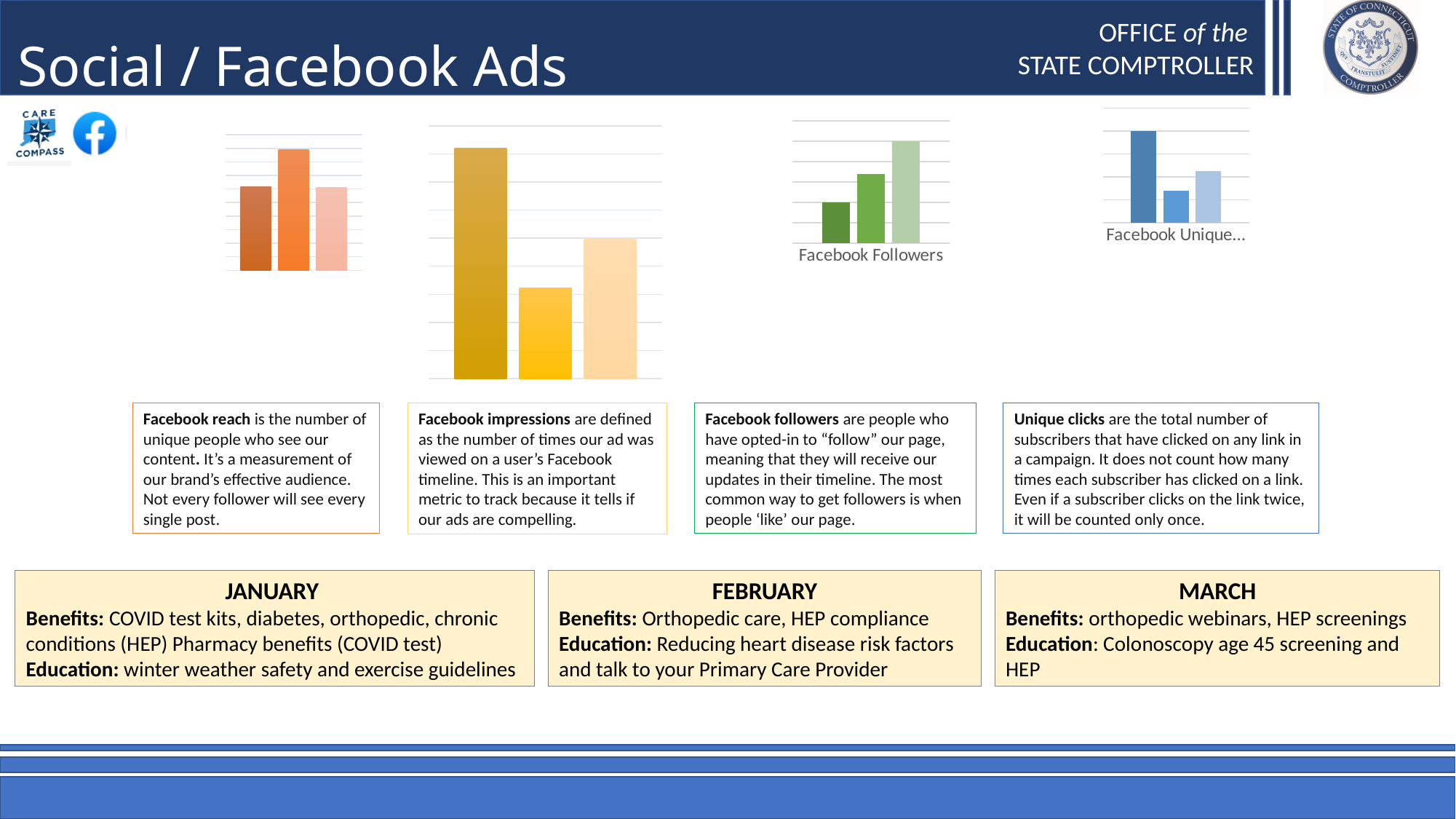
In the yellow chart (second from the left), which bar is the shortest: the leftmost, middle, or rightmost? middle In the orange chart (leftmost on the slide), which bar is the tallest: the leftmost, middle, or rightmost? middle In the yellow chart (second from the left), which bar is the tallest: the leftmost, middle, or rightmost? leftmost How many bars does the 'Facebook Followers' chart have? 3 In the 'Facebook Followers' chart, do the bars rise or fall from left to right? rise In the 'Facebook Followers' chart, which bar is the tallest: the leftmost, middle, or rightmost? rightmost How many bar charts are shown on the slide? 4 In the chart titled 'Facebook Unique...', is the leftmost bar or the rightmost bar taller? leftmost What kind of chart is the 'Facebook Followers' chart? bar chart In the 'Facebook Followers' chart, which bar is the shortest: the leftmost, middle, or rightmost? leftmost In the chart titled 'Facebook Unique...', which bar is the shortest: the leftmost, middle, or rightmost? middle